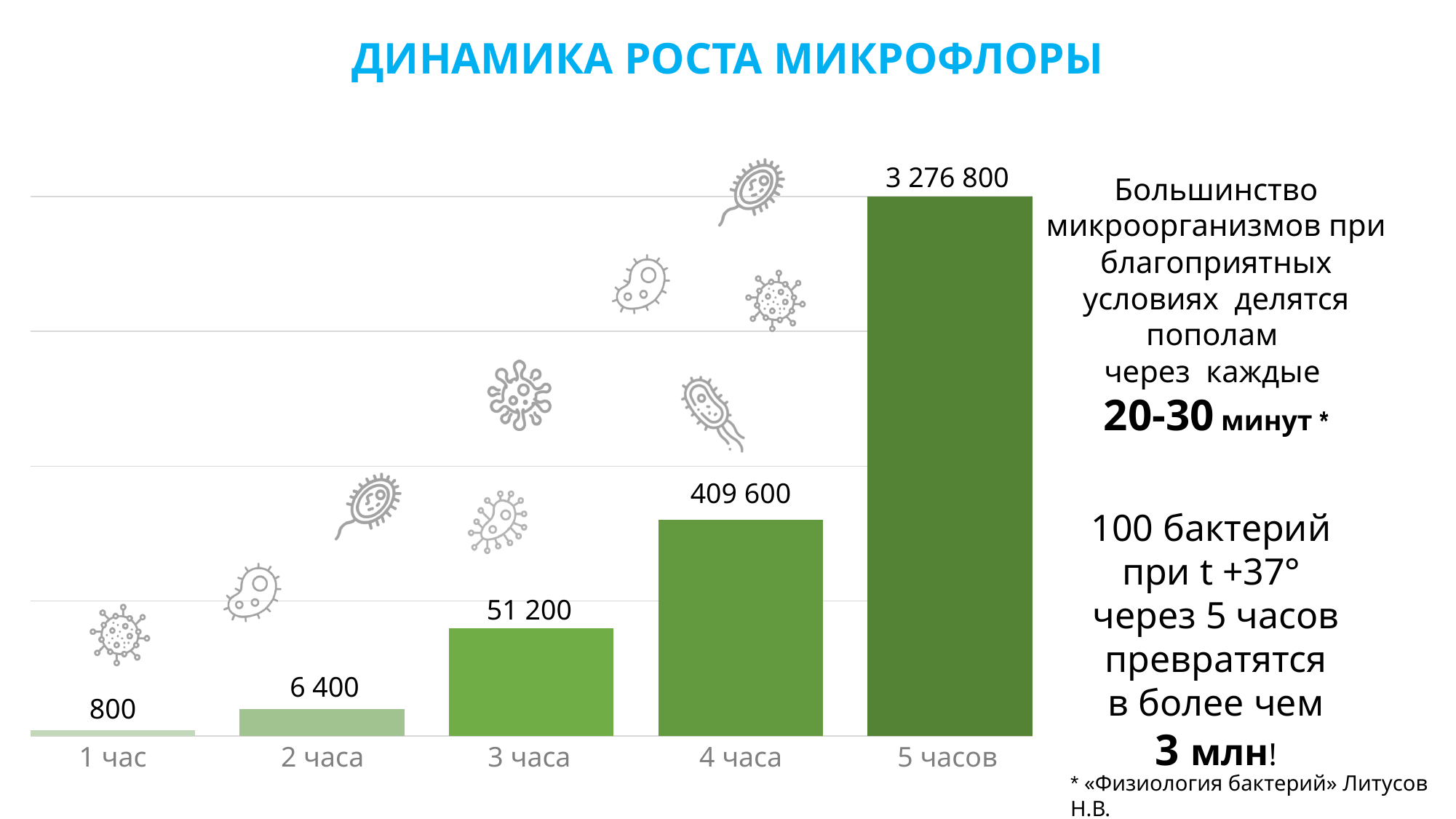
Which category has the lowest value? 1 час Which is larger, the value for 2 часа or the value for 3 часа? 3 часа What is the difference between the values for 4 часа and 3 часа? 358 400 Which category has the highest value? 5 часов What is the difference between the values for 2 часа and 1 час? 5 600 What is the value for 3 часа? 51 200 What is the value for 4 часа? 409 600 What is the value for 1 час? 800 Do the values rise or fall from 1 час to 5 часов? rise What is the value for 5 часов? 3 276 800 What kind of chart is shown on the slide? bar chart How many categories are shown on the x axis? 5